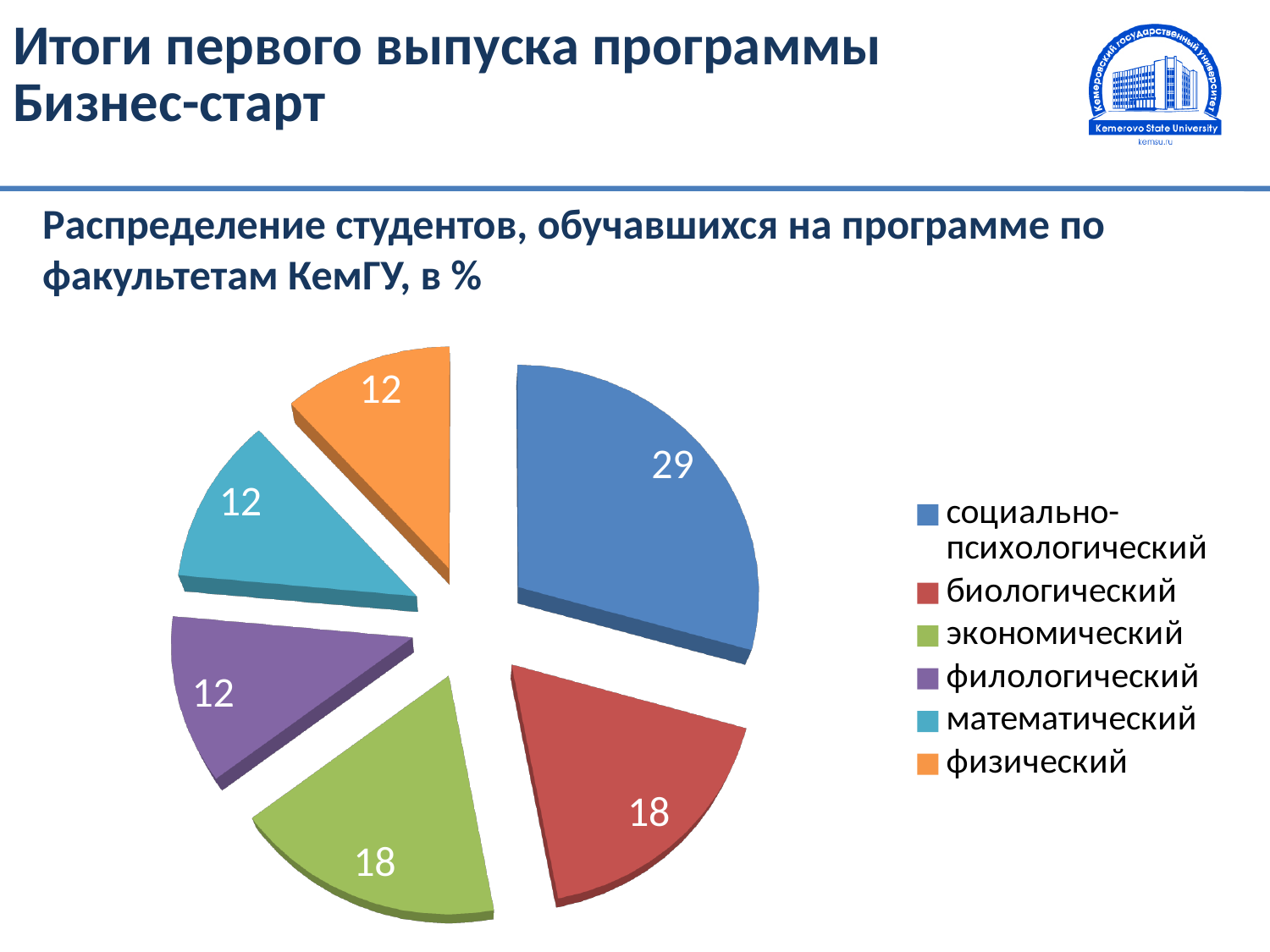
What is the difference between the values for социально-психологический and экономический? 11 What is the value for филологический? 12 What is the value for биологический? 18 What is the value for физический? 12 Which faculty has the largest slice of the pie? социально-психологический How many faculties (slices) are shown in the pie chart? 6 What colour is the slice for математический? light blue How many entries does the legend list? 6 What type of chart is shown on the slide? pie chart Which is larger, the value for экономический or the value for филологический? экономический What is the difference between the values for биологический and математический? 6 What is the value for социально-психологический? 29